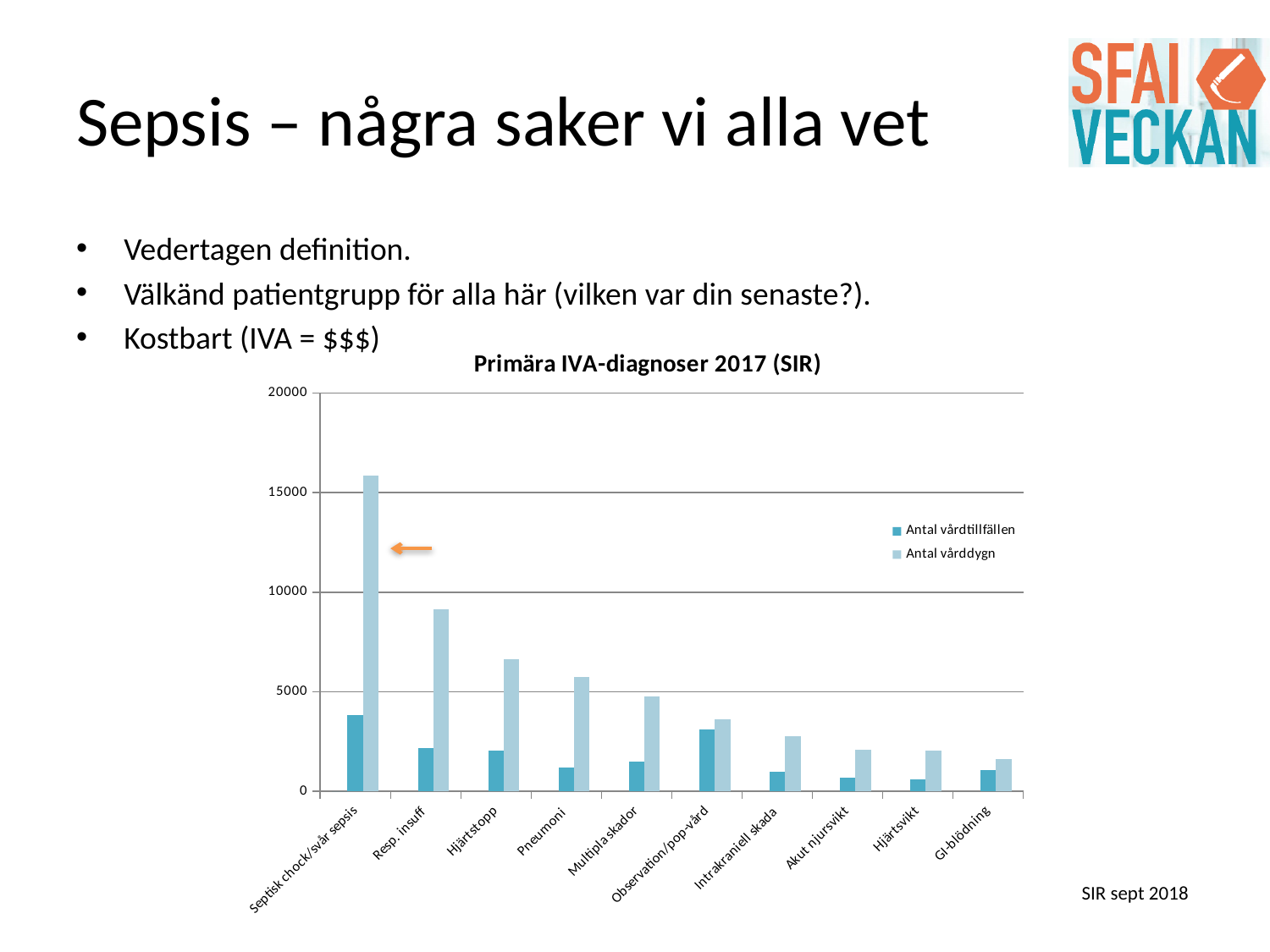
How many diagnosis categories are shown on the x axis? 10 Is the Antal vårddygn value for Hjärtstopp greater or less than 5000? greater What type of chart is shown on the slide? Bar chart How many series does the chart legend list? 2 Is the Antal vårddygn value for Resp. insuff greater or less than 10000? less Is the Antal vårddygn value for Septisk chock/svår sepsis greater or less than 15000? greater Which category has the highest value for Antal vårddygn? Septisk chock/svår sepsis Which is larger: Antal vårddygn for Resp. insuff or Antal vårddygn for Pneumoni? Resp. insuff Which category has the lowest value for Antal vårddygn? GI-blödning What is the title of the chart? Primära IVA-diagnoser 2017 (SIR) Which category has the highest value for Antal vårdtillfällen? Septisk chock/svår sepsis Do the Antal vårddygn values generally rise or fall from left to right along the x axis? Fall